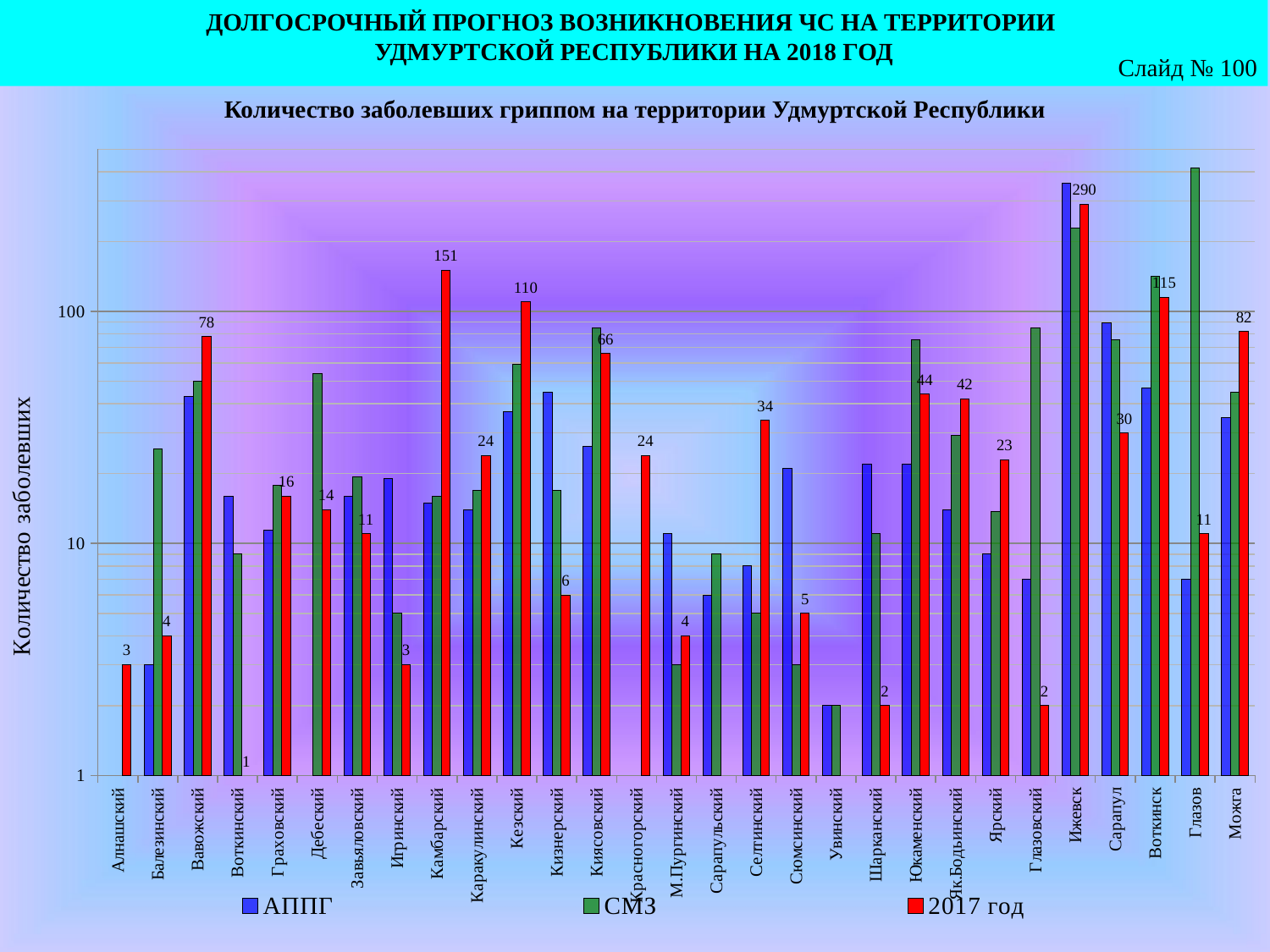
What is the title of the chart? Количество заболевших гриппом на территории Удмуртской Республики How many series does the legend list? 3 What is the value for Камбарский in the 2017 год series? 151 In the 2017 год series, which is larger: Вавожский or Киясовский? Вавожский Which category has the highest value in the 2017 год series? Ижевск What is the value for Можга in the 2017 год series? 82 What is the value for Ижевск in the 2017 год series? 290 What kind of chart is shown on the slide? bar chart Is the СМЗ value for Глазов greater or less than 100? greater Is the АППГ value for Ижевск greater or less than 100? greater What is the difference between the 2017 год values for Воткинск and Кезский? 5 Which category has the lowest value in the 2017 год series? Воткинский